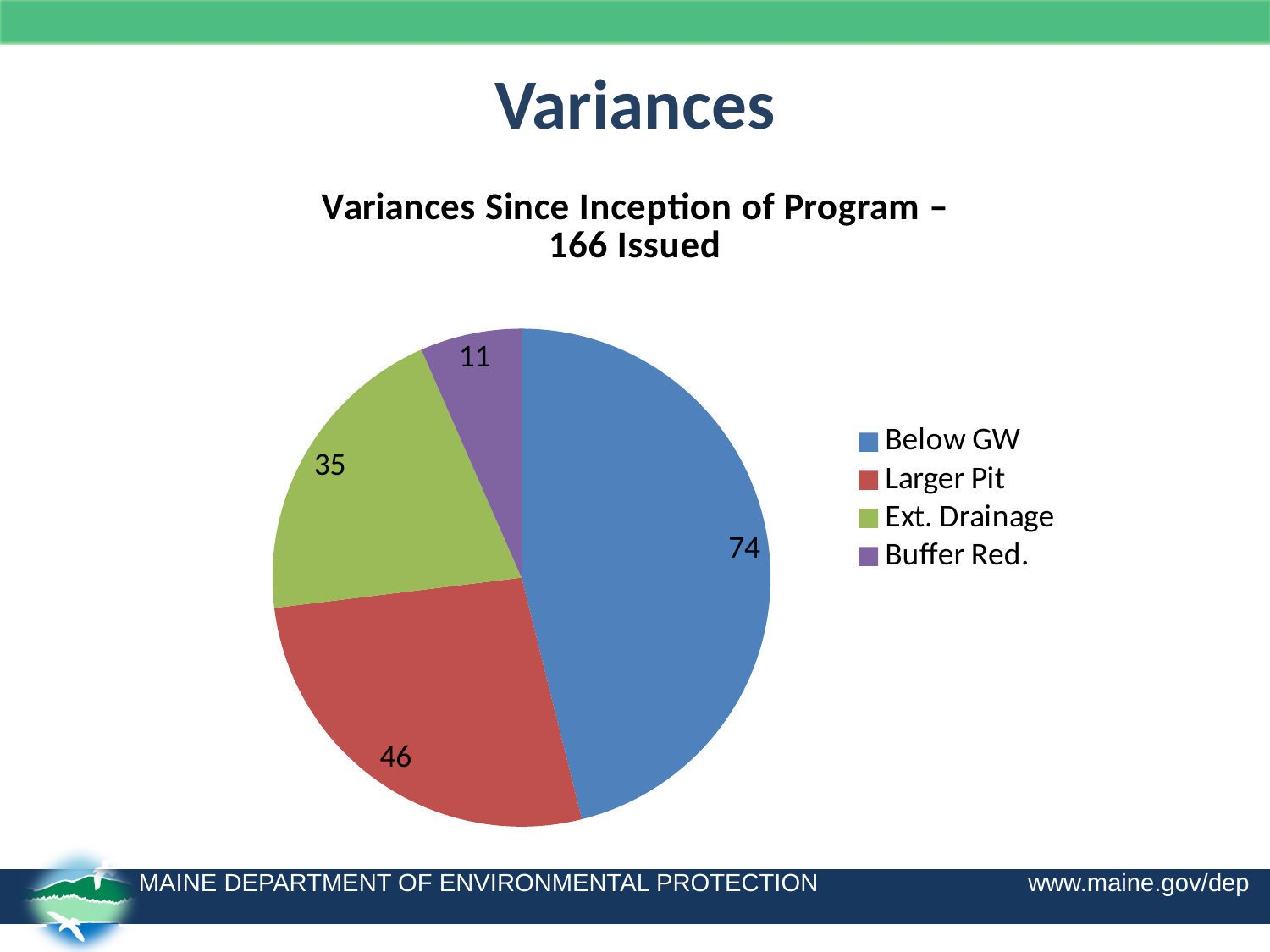
What is the value for Buffer Red.? 11 What is the value for Ext. Drainage? 35 What is the difference between the values for Below GW and Larger Pit? 28 What is the value for Below GW? 74 Which legend entry is shown in purple? Buffer Red. What type of chart is shown on the slide? pie chart What is the title of the chart? Variances Since Inception of Program – 166 Issued Which is larger, Ext. Drainage or Larger Pit? Larger Pit Which category has the largest slice? Below GW What is the value for Larger Pit? 46 How many slices does the pie chart have? 4 Which category has the smallest slice? Buffer Red.